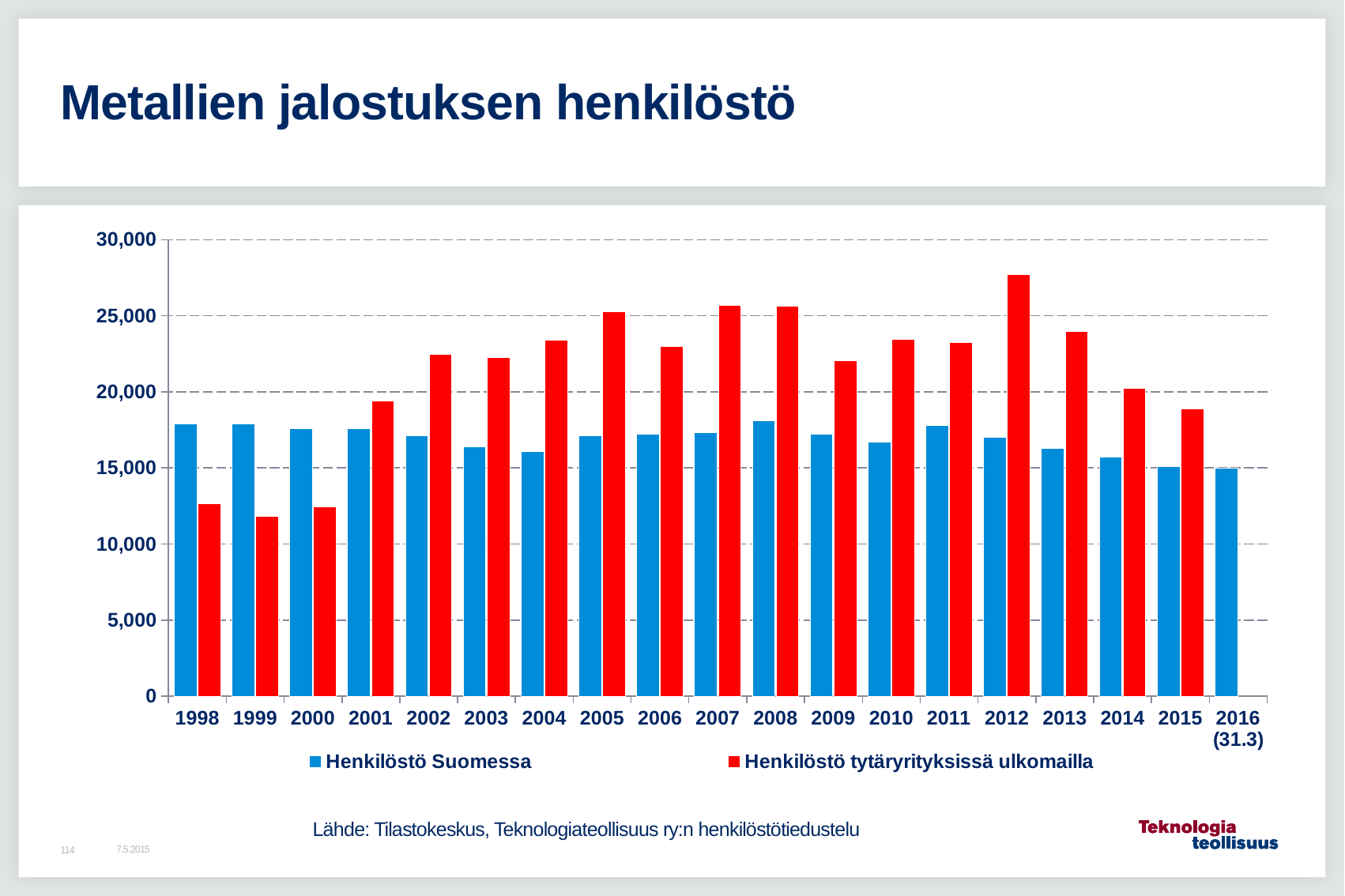
How many series does the legend list? 2 Is the value for Henkilöstö Suomessa in 2014 greater or less than 15,000? greater How many years (categories) are shown on the x axis? 19 In which year is the value for Henkilöstö tytäryrityksissä ulkomailla highest? 2012 Is the value for Henkilöstö tytäryrityksissä ulkomailla in 1999 greater or less than 15,000? less Which colour represents Henkilöstö Suomessa in the chart? Blue In which year is the value for Henkilöstö tytäryrityksissä ulkomailla lowest? 1999 Is the value for Henkilöstö tytäryrityksissä ulkomailla in 2012 greater or less than 25,000? greater What kind of chart is shown on the slide? Bar chart In 1998, which is larger: Henkilöstö Suomessa or Henkilöstö tytäryrityksissä ulkomailla? Henkilöstö Suomessa In 2012, which is larger: Henkilöstö Suomessa or Henkilöstö tytäryrityksissä ulkomailla? Henkilöstö tytäryrityksissä ulkomailla